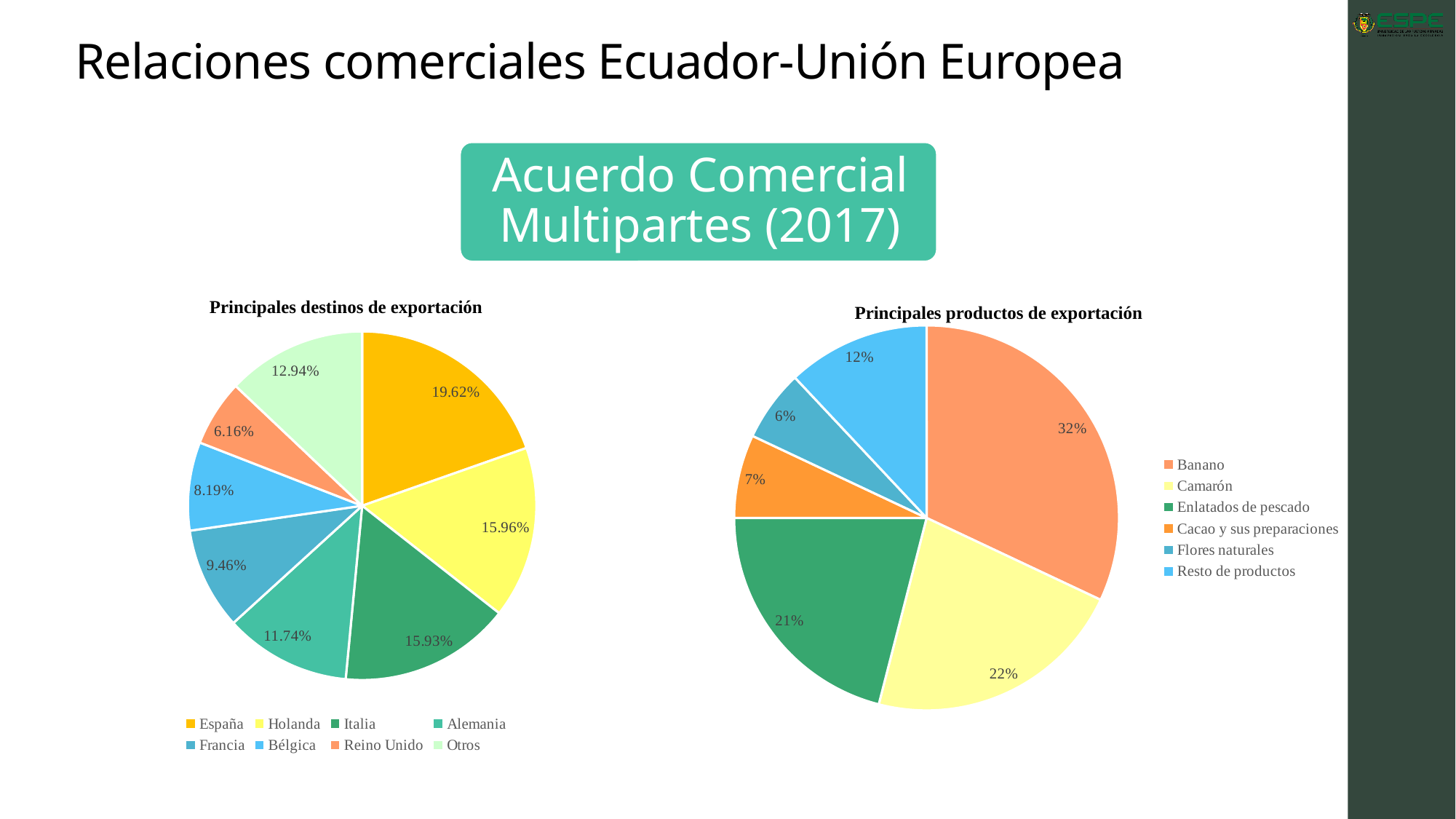
In the 'Principales productos de exportación' chart, what share does Flores naturales have? 6% What type of chart is 'Principales productos de exportación'? Pie chart In the 'Principales destinos de exportación' chart, what is the difference between the shares of Francia and Bélgica? 1.27% In the 'Principales destinos de exportación' chart, what share does Alemania have? 11.74% In the 'Principales productos de exportación' chart, which product has the largest share? Banano In the 'Principales destinos de exportación' chart, which destination has the smallest share? Reino Unido In the 'Principales destinos de exportación' chart, what share does España have? 19.62% In the 'Principales productos de exportación' chart, what share does Banano have? 32% In the 'Principales destinos de exportación' chart, which destination has the largest share? España In the 'Principales destinos de exportación' chart, how many slices does the pie have? 8 In the 'Principales productos de exportación' chart, which is larger, the share of Cacao y sus preparaciones or Resto de productos? Resto de productos In the 'Principales productos de exportación' chart, what is the difference between the shares of Banano and Camarón? 10%